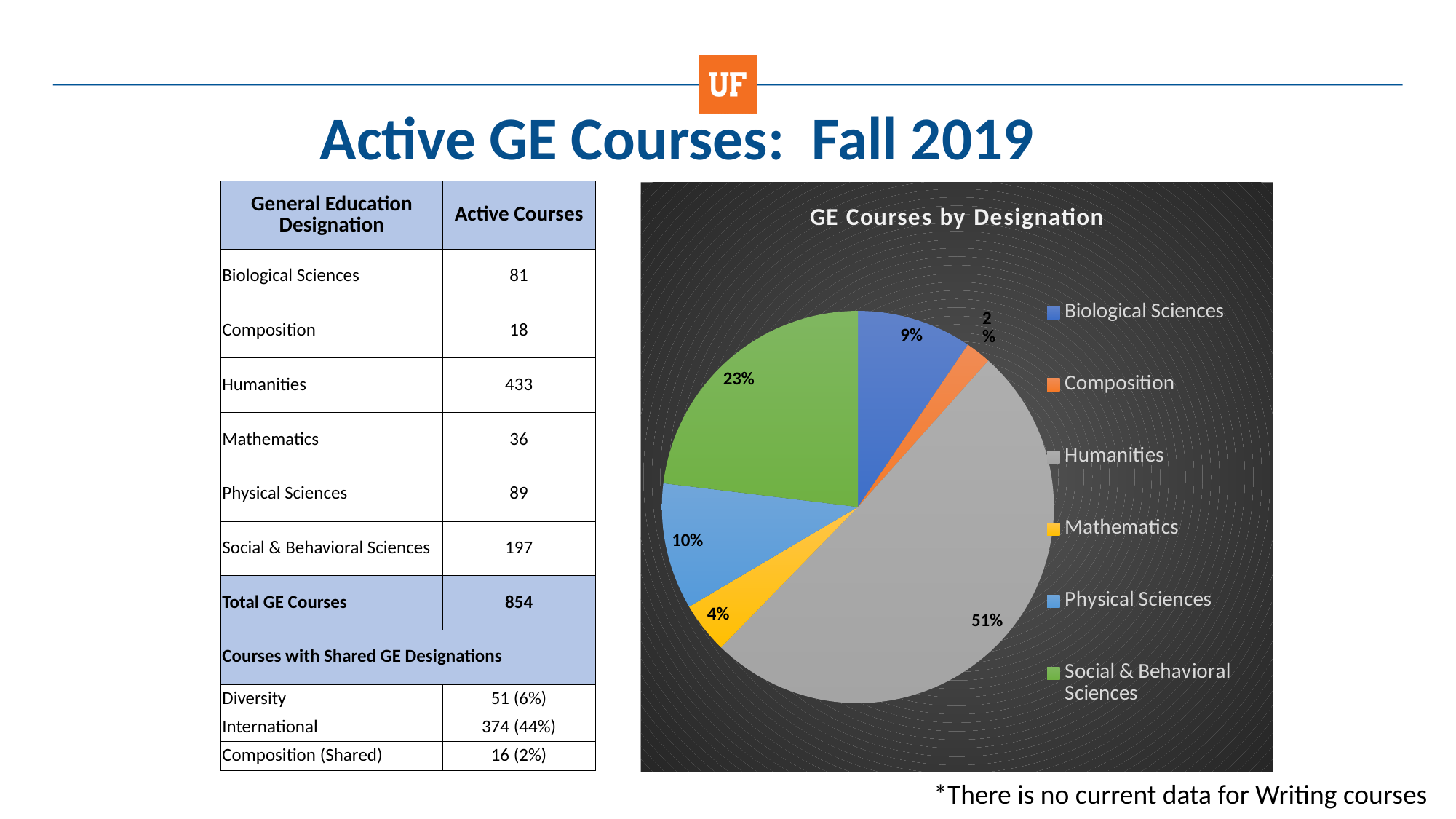
Which designation has the largest slice of the pie? Humanities Which slice is larger, Biological Sciences or Physical Sciences? Physical Sciences What percentage of the pie does Humanities represent? 51% What type of chart is shown on the slide? pie chart How many percentage points larger is the Humanities slice than the Social & Behavioral Sciences slice? 28 percentage points How many slices does the pie chart have? 6 What percentage of the pie does Physical Sciences represent? 10% What percentage of the pie does Social & Behavioral Sciences represent? 23% What percentage of the pie does Mathematics represent? 4% What is the title of the chart? GE Courses by Designation Which designation has the smallest slice of the pie? Composition How many entries does the chart legend list? 6